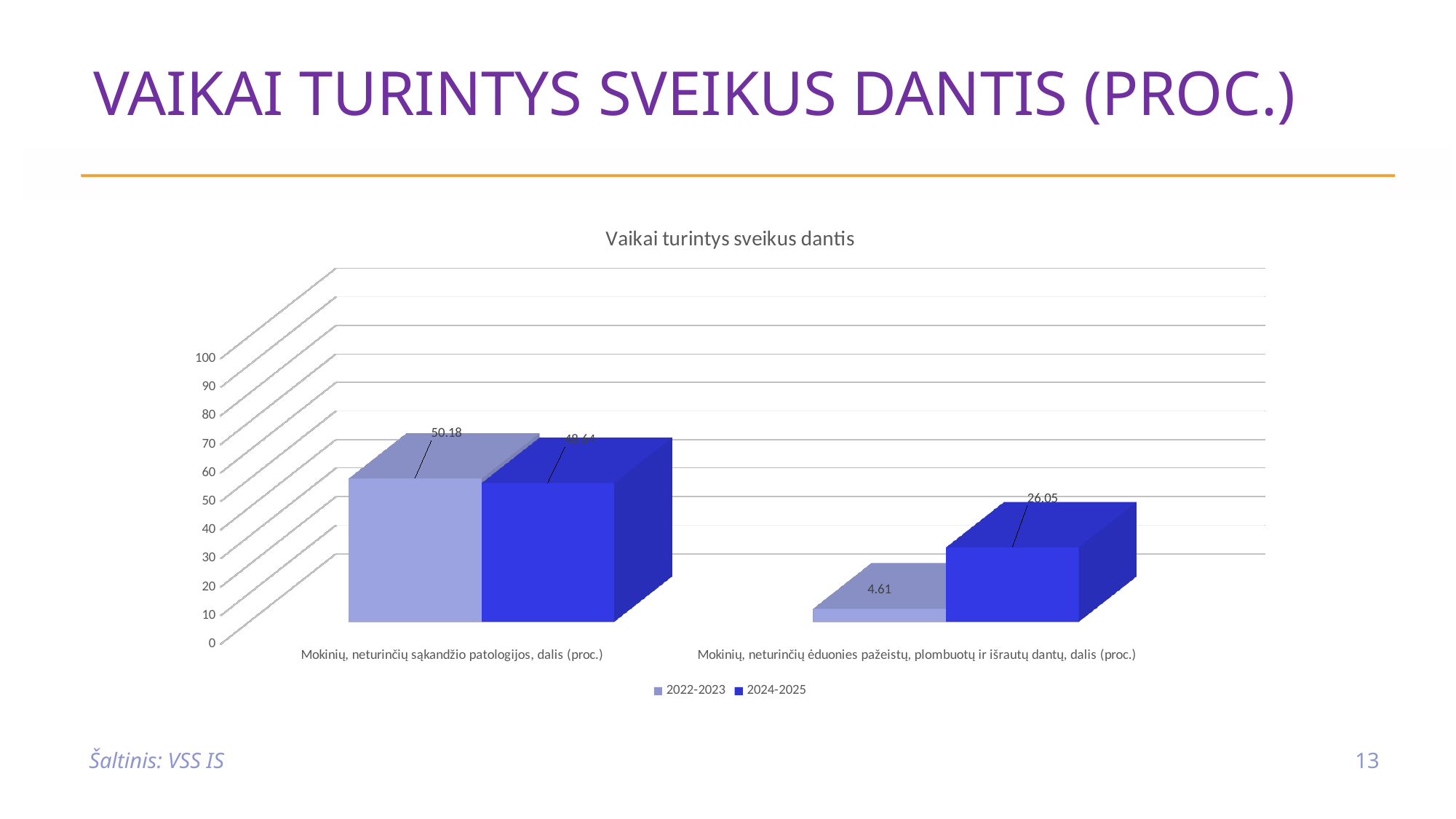
For 'Mokinių, neturinčių ėduonies pažeistų, plombuotų ir išrautų dantų, dalis (proc.)', which series has the larger value, 2022-2023 or 2024-2025? 2024-2025 For 'Mokinių, neturinčių ėduonies pažeistų, plombuotų ir išrautų dantų, dalis (proc.)', how much higher is the 2024-2025 value than the 2022-2023 value? 21.44 How many series does the legend list? 2 What is the 2022-2023 value for 'Mokinių, neturinčių ėduonies pažeistų, plombuotų ir išrautų dantų, dalis (proc.)'? 4.61 What is the 2022-2023 value for 'Mokinių, neturinčių sąkandžio patologijos, dalis (proc.)'? 50.18 What is the 2024-2025 value for 'Mokinių, neturinčių ėduonies pažeistų, plombuotų ir išrautų dantų, dalis (proc.)'? 26.05 Is the 2024-2025 value for 'Mokinių, neturinčių sąkandžio patologijos, dalis (proc.)' greater or less than 40? greater How many categories are shown on the x axis of the chart? 2 What kind of chart is shown on the slide? bar chart Which bar has the lowest value in the chart? 2022-2023 for 'Mokinių, neturinčių ėduonies pažeistų, plombuotų ir išrautų dantų, dalis (proc.)' (4.61) Which bar has the highest value in the chart? 2022-2023 for 'Mokinių, neturinčių sąkandžio patologijos, dalis (proc.)' (50.18) What is the title of the chart? Vaikai turintys sveikus dantis